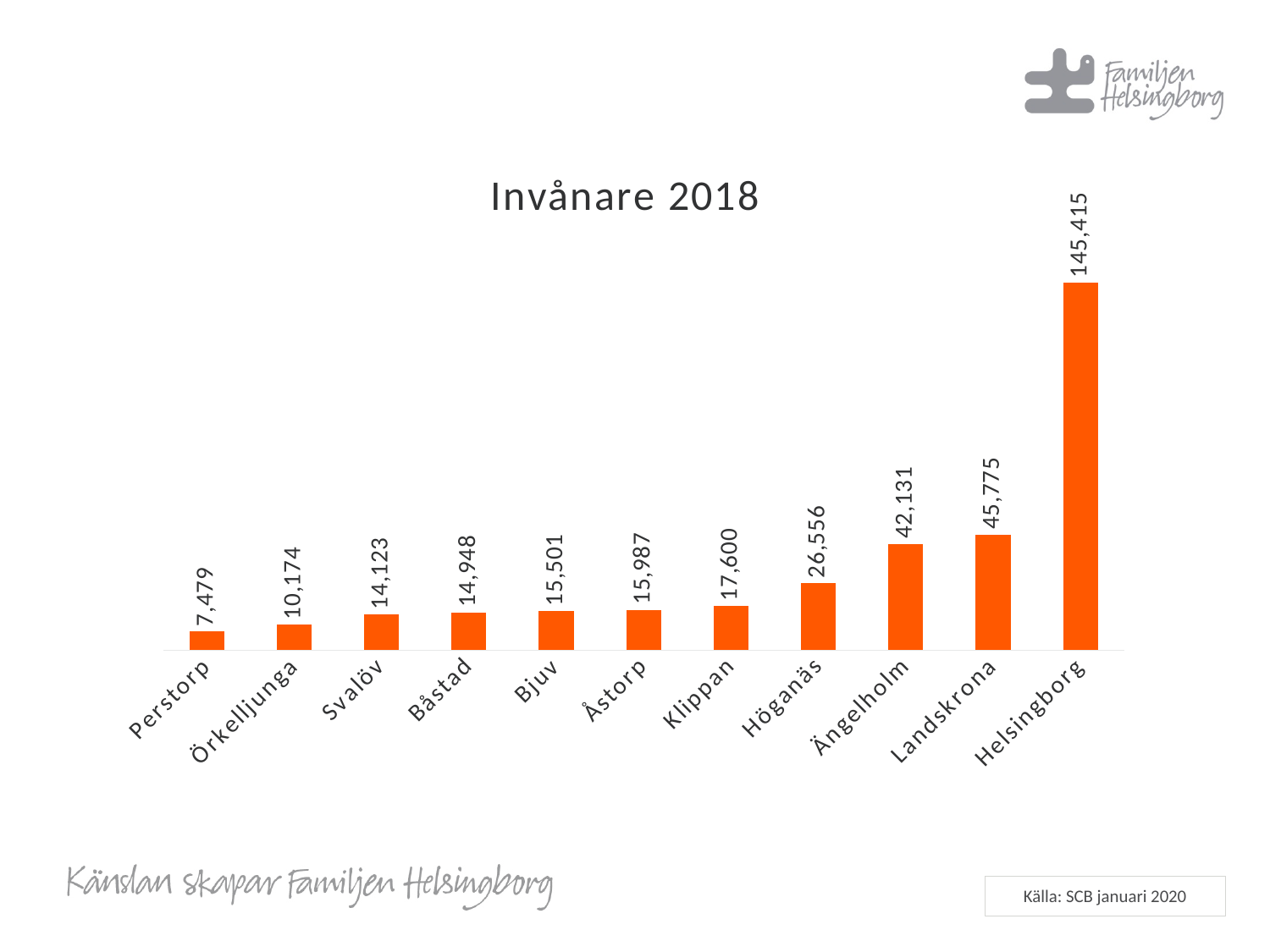
How many municipalities are shown in the Invånare 2018 chart? 11 What is the difference between the values for Helsingborg and Landskrona in the Invånare 2018 chart? 99,640 What is the value for Helsingborg in the Invånare 2018 chart? 145,415 Which municipality has the highest value in the Invånare 2018 chart? Helsingborg What is the value for Perstorp in the Invånare 2018 chart? 7,479 What kind of chart is the Invånare 2018 chart? Bar chart Do the values in the Invånare 2018 chart rise or fall from left to right along the x axis? Rise Which municipality has the lowest value in the Invånare 2018 chart? Perstorp What is the value for Höganäs in the Invånare 2018 chart? 26,556 What is the value for Båstad in the Invånare 2018 chart? 14,948 What is the difference between the values for Landskrona and Ängelholm in the Invånare 2018 chart? 3,644 Which has a larger value in the Invånare 2018 chart, Klippan or Höganäs? Höganäs